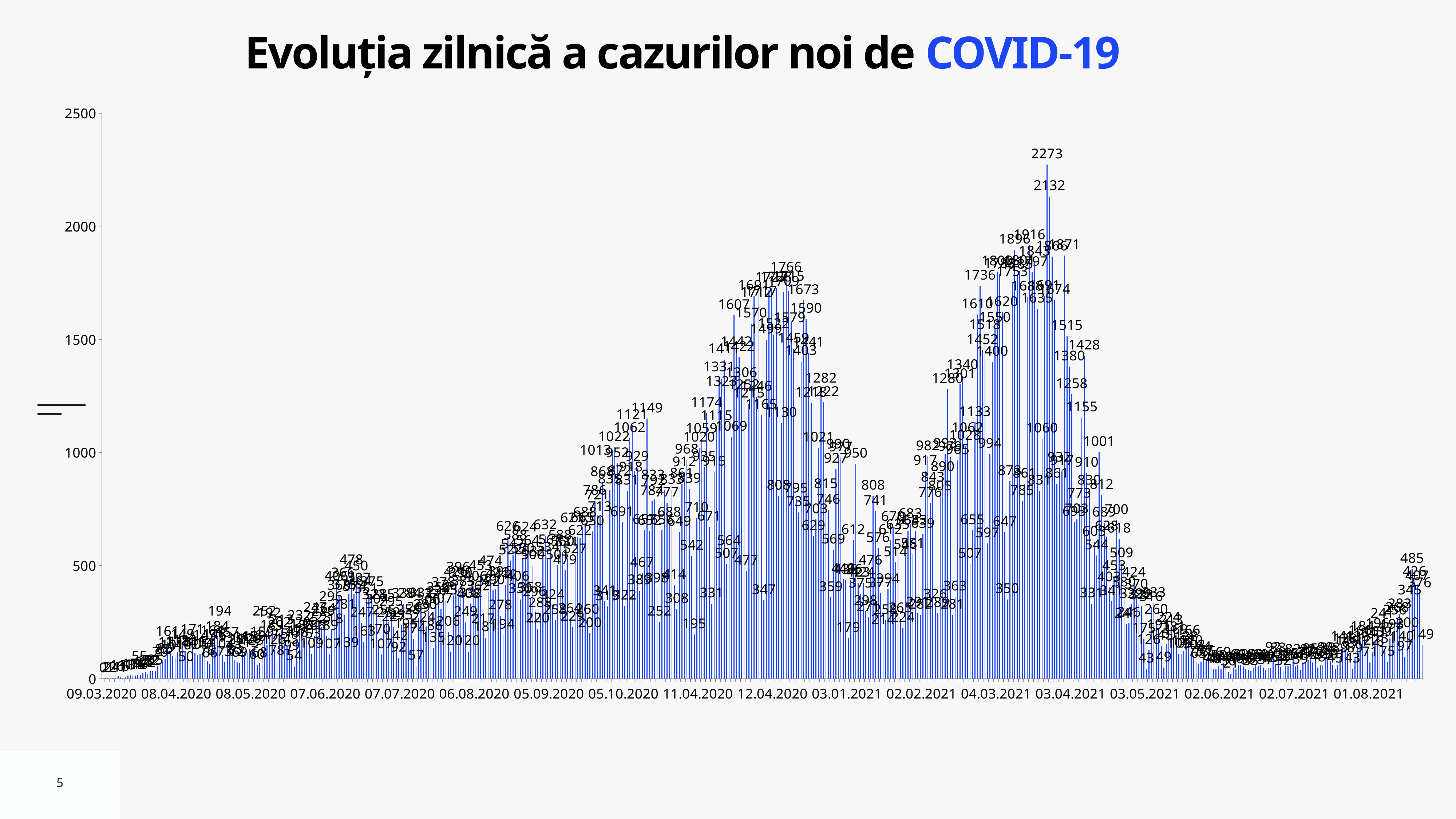
Is the highest bar on the chart greater or less than 2000? greater Between 03.04.2021 and 03.05.2021, do the daily values rise or fall? fall Between 02.07.2021 and 01.08.2021, do the daily values rise or fall? rise What is the highest value shown on the vertical axis? 2500 What is the difference between the two highest labelled values, 2273 and 2132? 141 What is the highest daily value labelled on the chart? 2273 What is the title of the chart? Evoluția zilnică a cazurilor noi de COVID-19 What is the second-highest daily value labelled on the chart, just after the 2273 peak? 2132 Is the value for the first date, 09.03.2020, greater or less than 500? less Are the values around 02.06.2021 greater or less than 500? less What kind of chart is shown on the slide? bar chart Which is larger: the peak of the autumn 2020 wave labelled 1766 or the peak of the spring 2021 wave labelled 2273? 2273